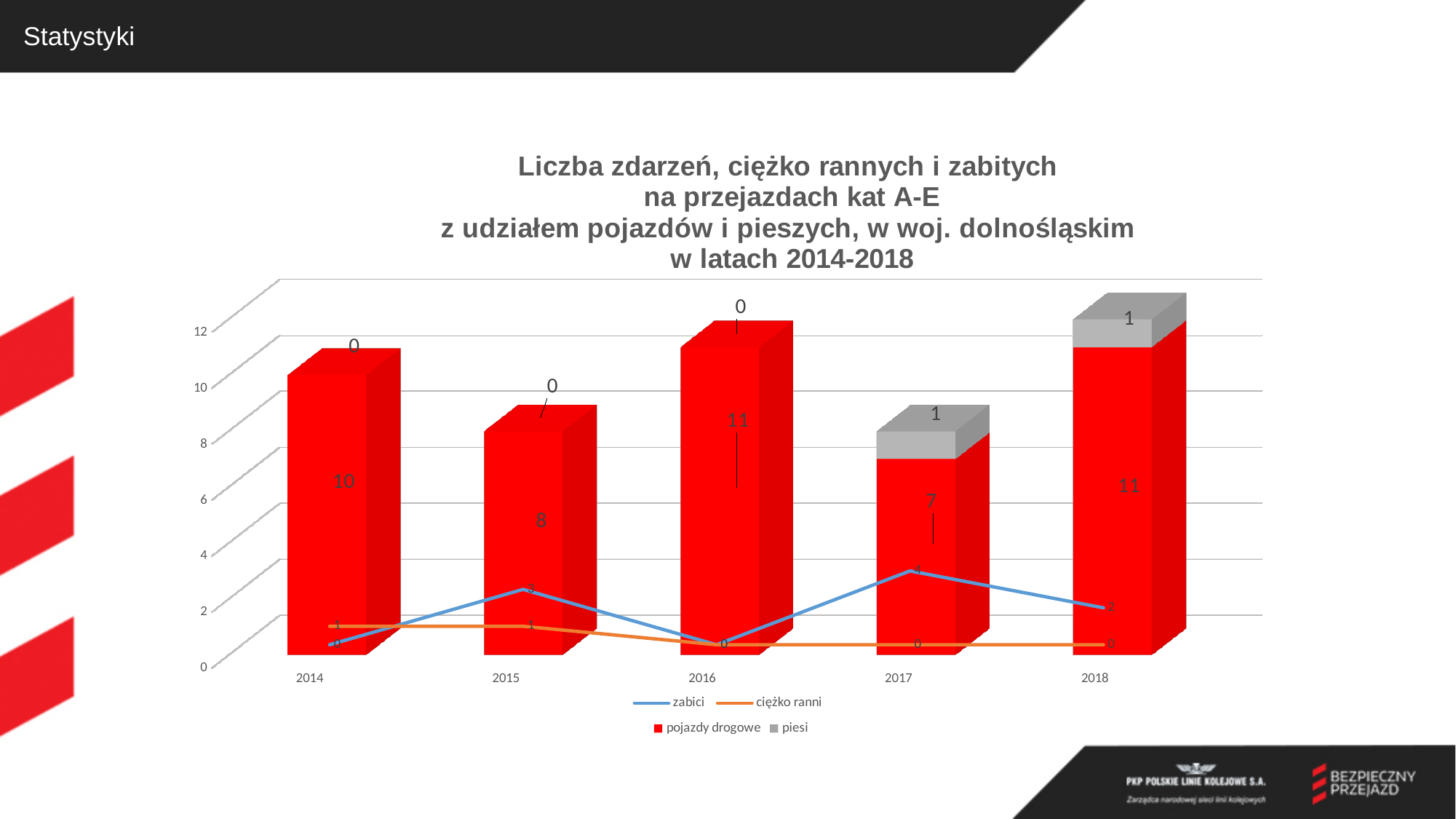
How many series does the legend list? 4 What is the value for pojazdy drogowe in 2016? 11 What is the difference between the pojazdy drogowe values for 2014 and 2015? 2 Which is larger, the pojazdy drogowe value for 2016 or for 2015? 2016 What is the value for piesi in 2018? 1 What is the value for piesi in 2014? 0 What is the value for ciężko ranni in 2015? 1 How many years are shown on the x axis? 5 Which year has the lowest value for pojazdy drogowe? 2017 What is the value for pojazdy drogowe in 2017? 7 What is the value for zabici in 2017? 4 What is the total of the stacked bar for 2017 (pojazdy drogowe plus piesi)? 8